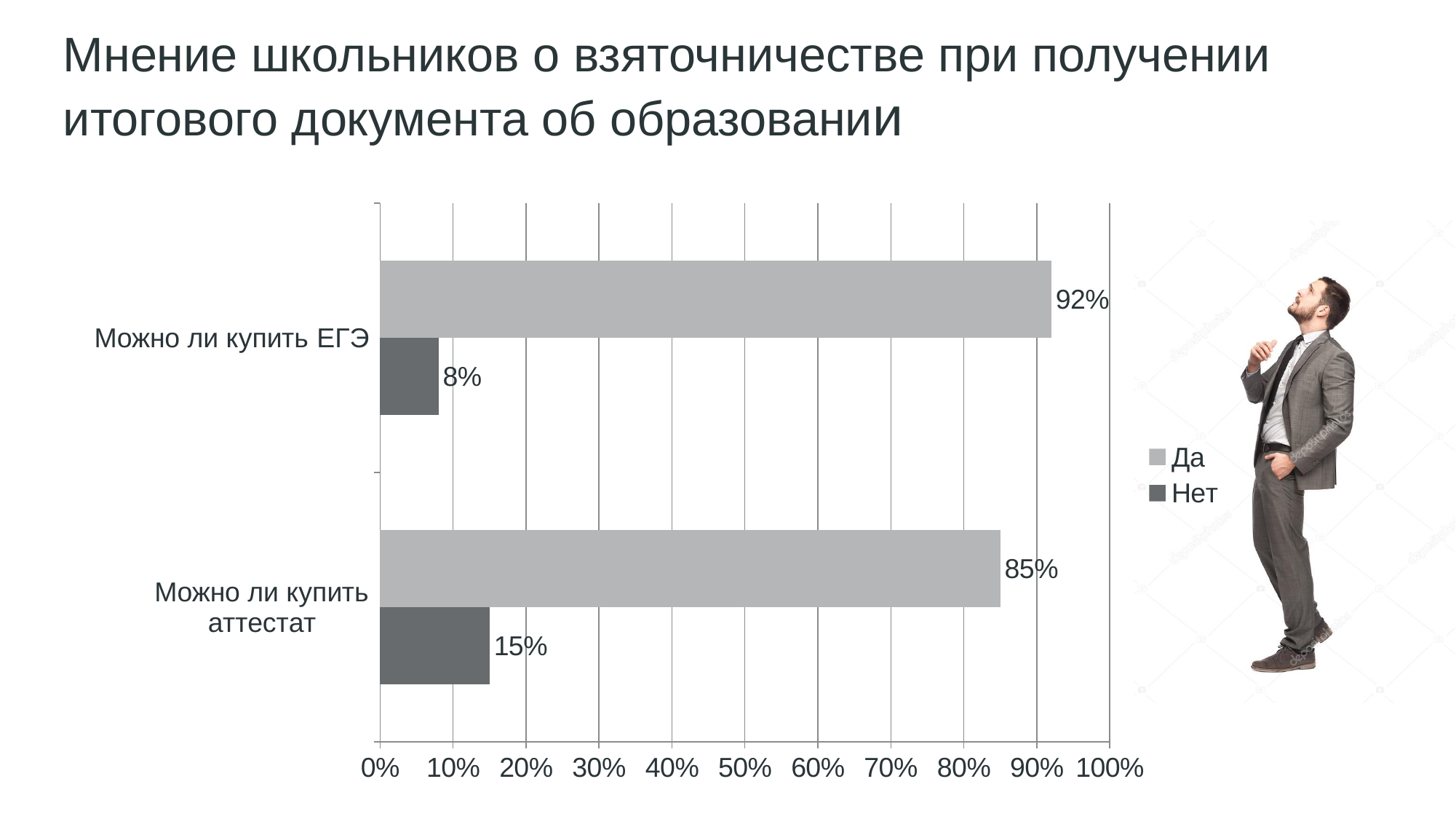
How many categories are shown on the chart? 2 What is the value of "Нет" for "Можно ли купить аттестат"? 15% What is the difference between the "Да" values for "Можно ли купить ЕГЭ" and "Можно ли купить аттестат"? 7% What is the value of "Да" for "Можно ли купить ЕГЭ"? 92% What is the value of "Да" for "Можно ли купить аттестат"? 85% What is the difference between the "Нет" values for "Можно ли купить аттестат" and "Можно ли купить ЕГЭ"? 7% How many series does the legend list? 2 Which category has the higher "Да" value? Можно ли купить ЕГЭ Is the "Нет" value for "Можно ли купить аттестат" larger or smaller than the "Нет" value for "Можно ли купить ЕГЭ"? larger What is the value of "Нет" for "Можно ли купить ЕГЭ"? 8% Which category has the lower "Нет" value? Можно ли купить ЕГЭ What kind of chart is shown on the slide? bar chart